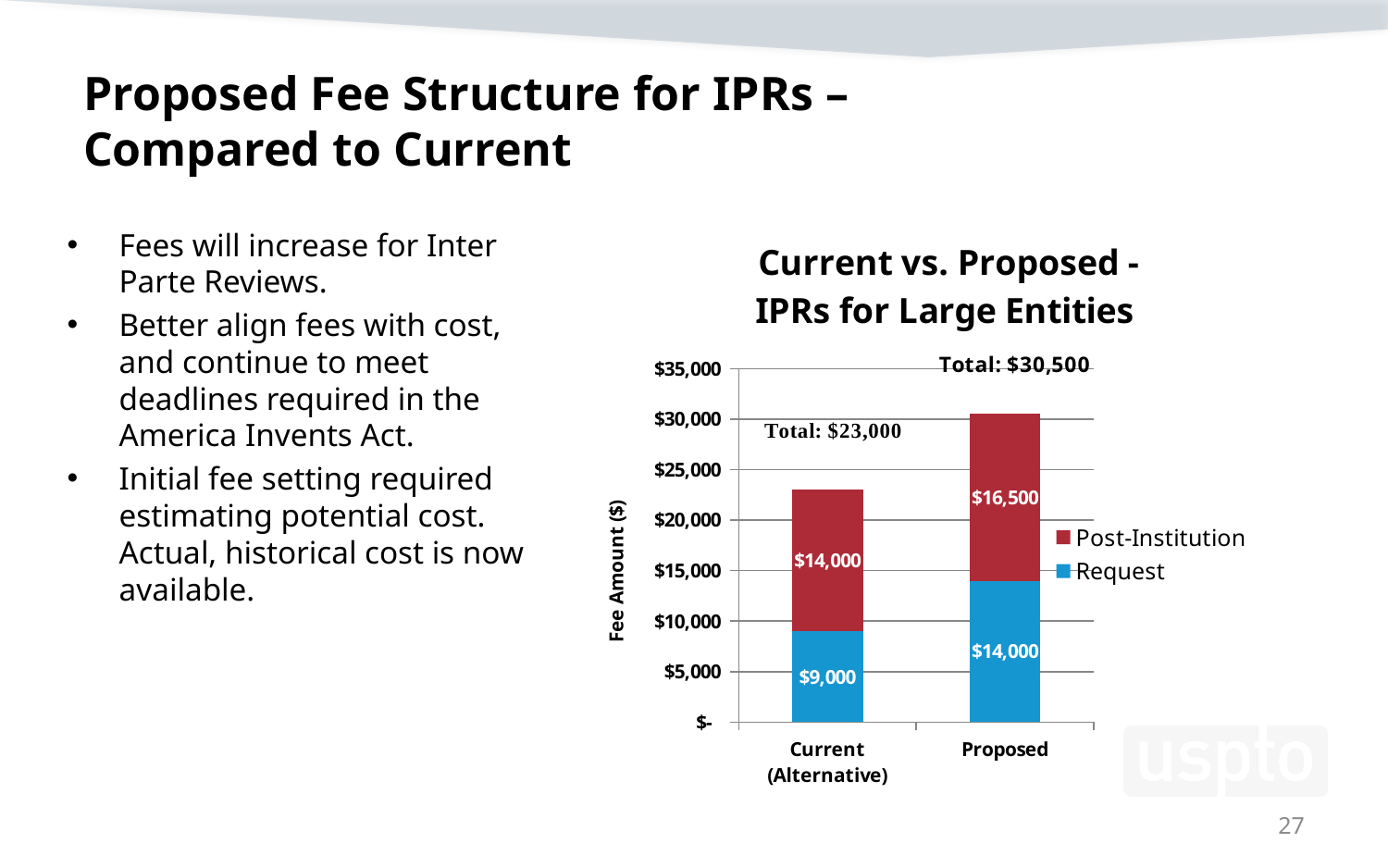
What is the title of the chart? Current vs. Proposed - IPRs for Large Entities What is the total of the Proposed stacked bar? $30,500 Which bar has the higher Request fee, Current (Alternative) or Proposed? Proposed What is the Post-Institution fee for the Current (Alternative) bar? $14,000 What is the Request fee for the Proposed bar? $14,000 What is the Post-Institution fee for the Proposed bar? $16,500 What kind of chart is shown on the slide? Stacked bar chart How many categories are shown on the x axis? 2 What is the total of the Current (Alternative) stacked bar? $23,000 What is the Request fee for the Current (Alternative) bar? $9,000 How many series does the legend list? 2 What is the difference between the Proposed total and the Current (Alternative) total? $7,500